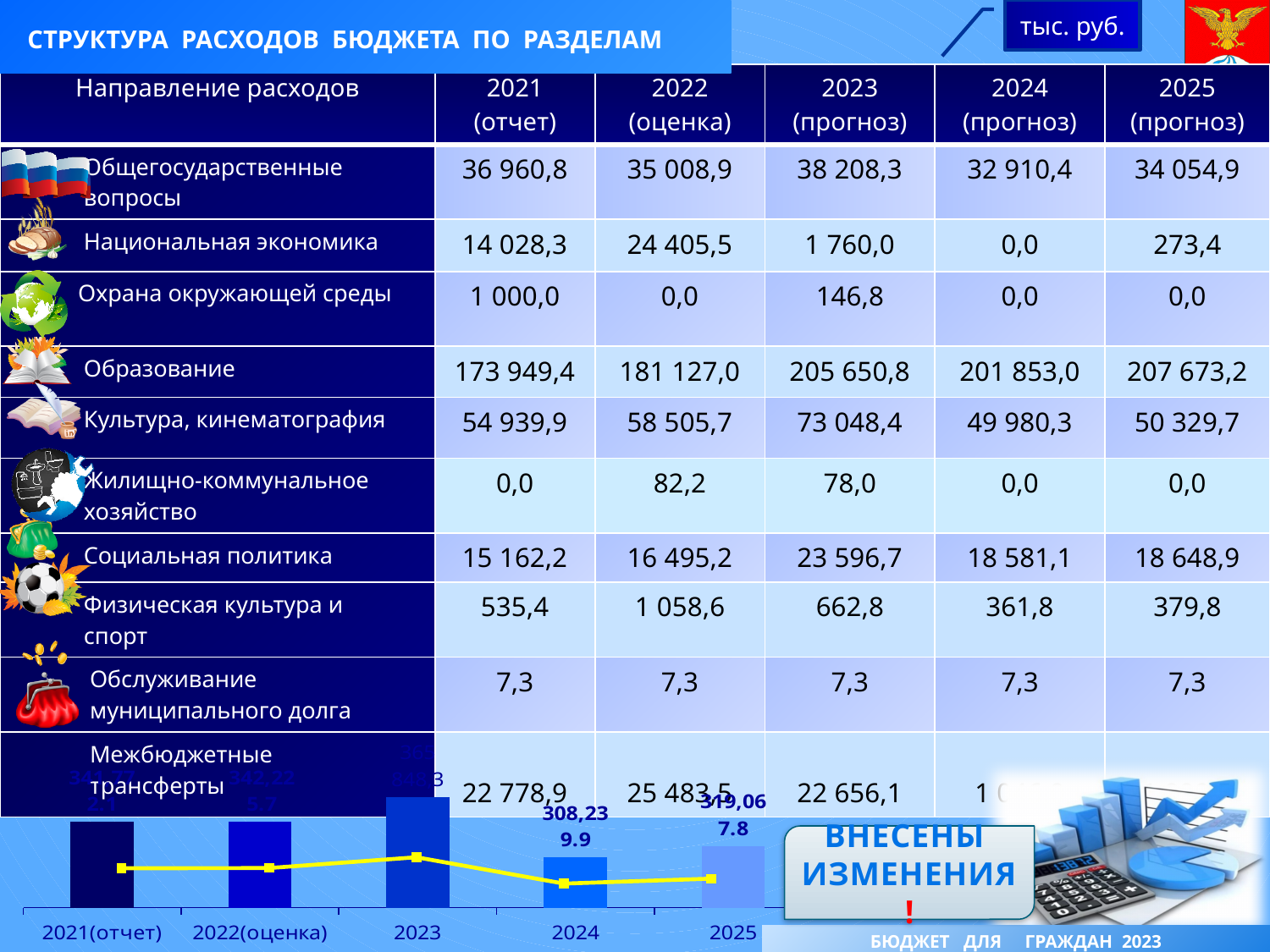
How many categories are shown on the x axis of the chart at the bottom of the slide? 5 In the chart at the bottom of the slide, what is the first category label on the x axis? 2021(отчет) In the chart at the bottom of the slide, which bar has the larger labelled value, 2024 or 2025? 2025 In the chart at the bottom of the slide, what is the second category label on the x axis? 2022(оценка) In the chart at the bottom of the slide, what is the data label on the bar for 2025? 319,067.8 In the chart at the bottom of the slide, what is the data label on the bar for 2024? 308,239.9 In the chart at the bottom of the slide, what is the difference between the labelled values for 2025 and 2024? 10,827.9 What kind of chart is shown at the bottom of the slide? A bar chart with a line